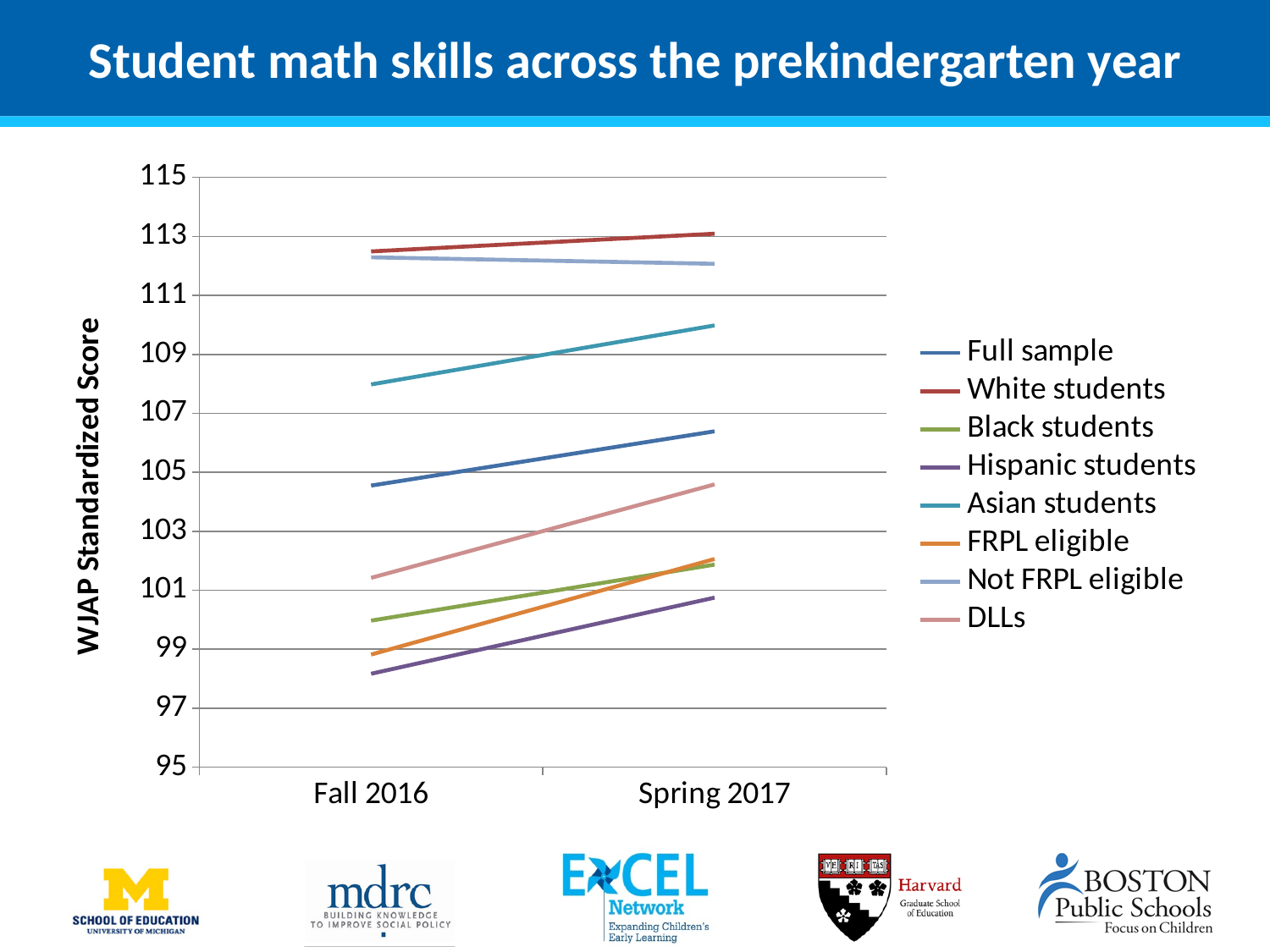
Is the Spring 2017 value for Full sample greater or less than 105? greater Which group has the lowest score in Fall 2016? Hispanic students In Spring 2017, which is higher: DLLs or Black students? DLLs What is the label on the y axis? WJAP Standardized Score Does the line for Not FRPL eligible rise or fall from Fall 2016 to Spring 2017? fall Is the Fall 2016 value for Hispanic students greater or less than 99? less Is the Fall 2016 value for Asian students greater or less than 107? greater How many series does the legend list? 8 How many time points are shown on the x axis? 2 Does the line for Asian students rise or fall from Fall 2016 to Spring 2017? rise What kind of chart is shown on the slide? line chart Which group has the highest score in Spring 2017? White students